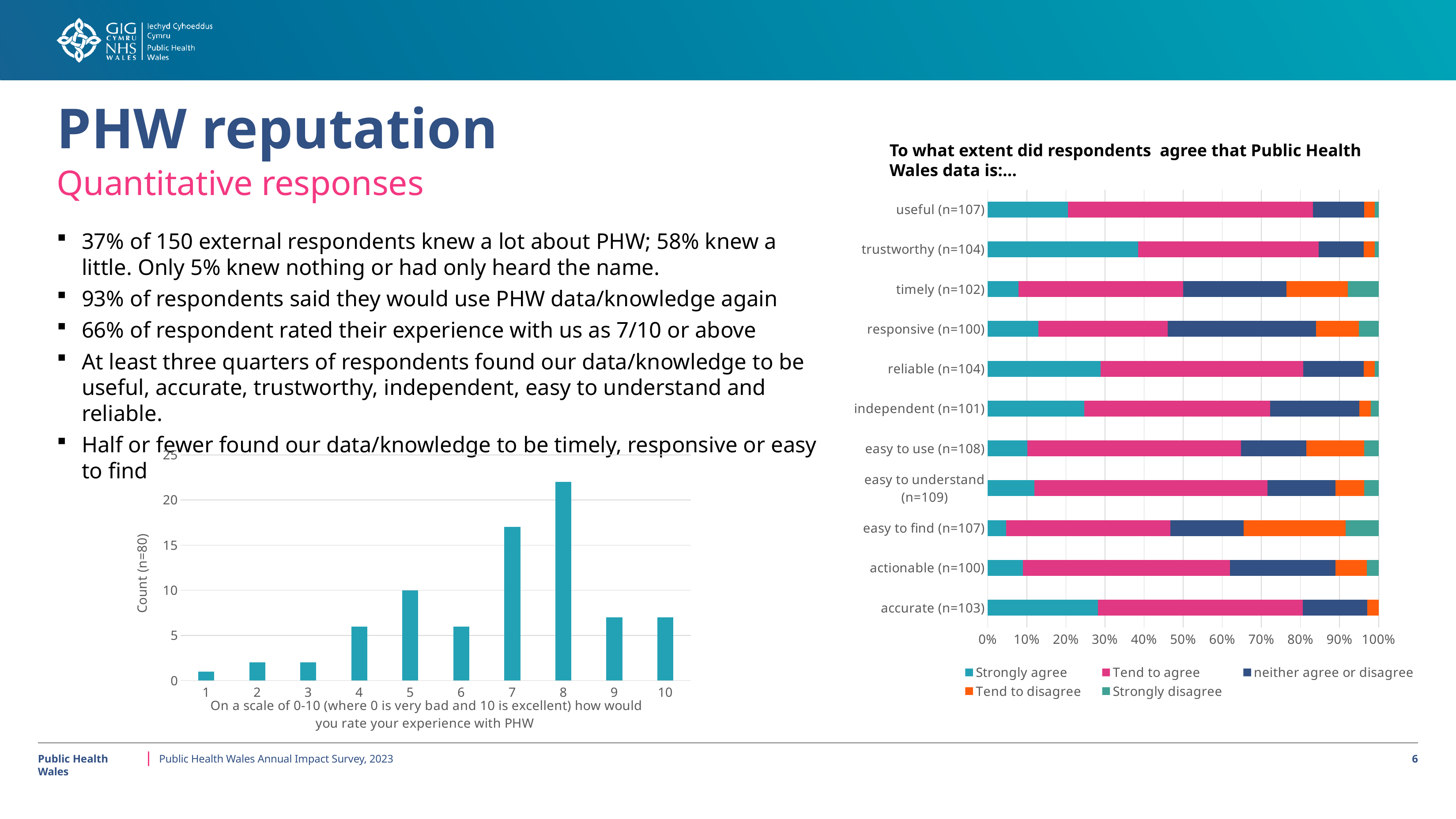
In the left chart, how many respondents gave a rating of 5? 10 What type of chart is the chart on the left of the slide? bar chart In the left chart, how many rating categories are shown on the x axis? 10 In the chart titled 'To what extent did respondents agree that Public Health Wales data is:...', how many series does the legend list? 5 In the left chart, which rating has the lowest count? 1 In the left chart, is the count for rating 8 greater or less than 20? greater In the left chart, is the count for rating 7 greater or less than 15? greater In the chart titled 'To what extent did respondents agree that Public Health Wales data is:...', is the 'Strongly agree' share for 'easy to find (n=107)' greater or less than 10%? less In the left chart, which rating has the highest count? 8 In the chart titled 'To what extent did respondents agree that Public Health Wales data is:...', how many categories are shown? 11 In the left chart, which rating has a higher count, 7 or 9? 7